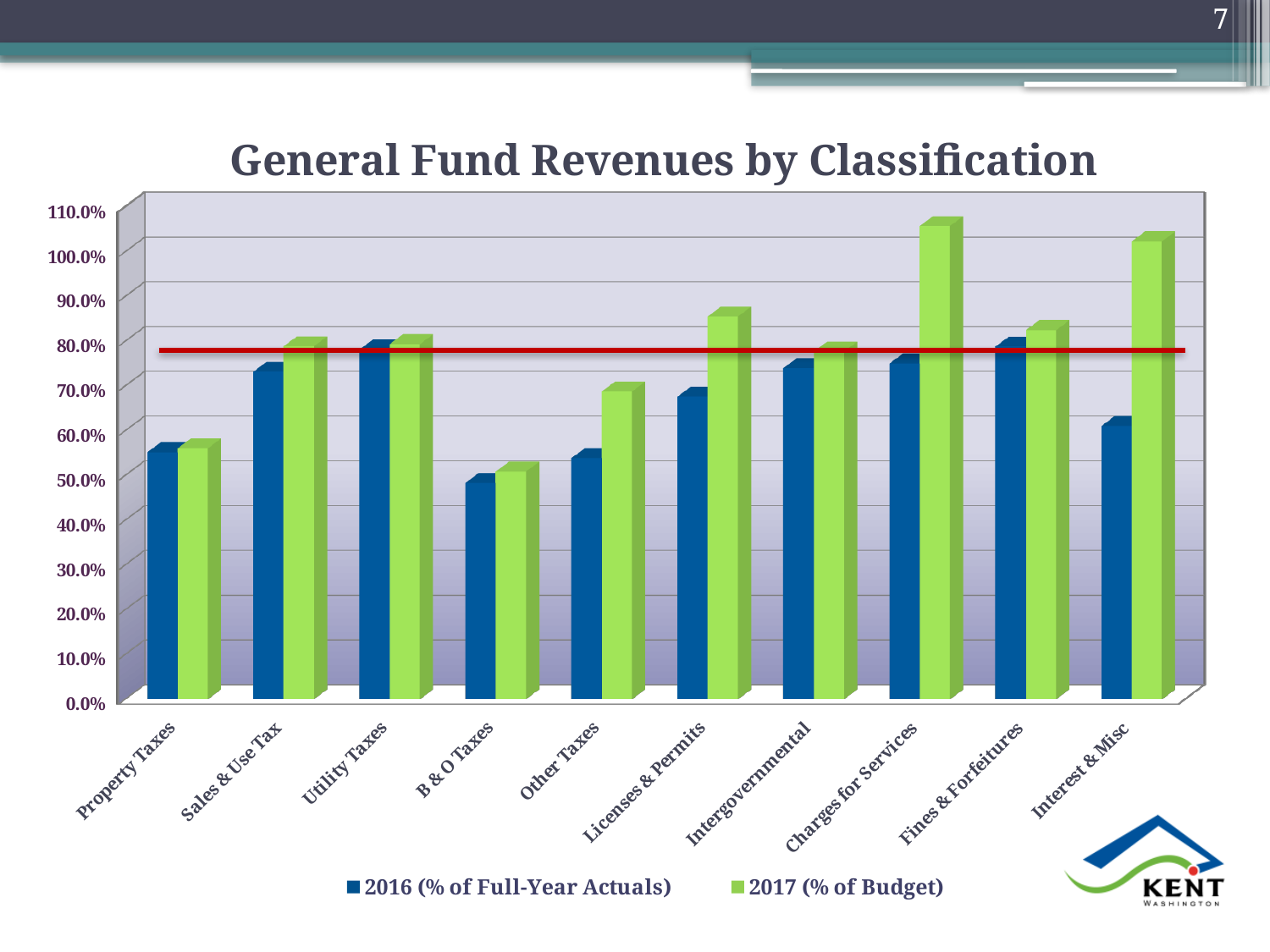
Is the 2016 (% of Full-Year Actuals) value for Property Taxes greater or less than 60.0%? less How many series does the legend list? 2 Which classification has the highest value for 2017 (% of Budget)? Charges for Services Which is larger for 2017 (% of Budget): Charges for Services or Licenses & Permits? Charges for Services Which classification has the lowest value for 2017 (% of Budget)? B & O Taxes What is the title of the chart? General Fund Revenues by Classification How many revenue classifications are shown on the x axis? 10 Which classification has the lowest value for 2016 (% of Full-Year Actuals)? B & O Taxes For Interest & Misc, which is larger: the 2016 (% of Full-Year Actuals) value or the 2017 (% of Budget) value? 2017 (% of Budget) Is the 2017 (% of Budget) value for Charges for Services greater or less than 100.0%? greater Is the 2017 (% of Budget) value for Interest & Misc greater or less than 90.0%? greater What kind of chart is shown on the slide? bar chart